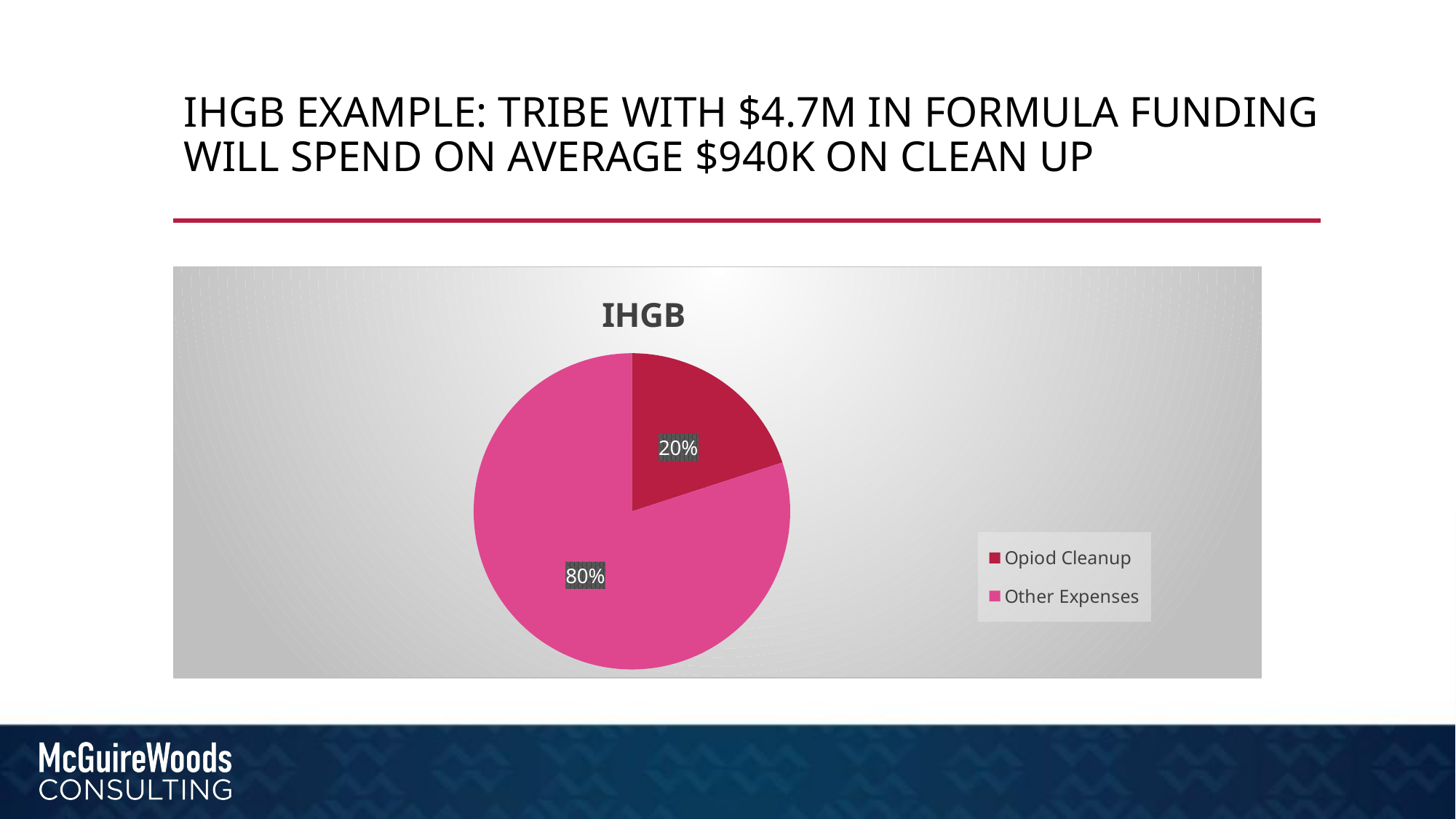
What type of chart is shown on the slide? Pie chart Which slice of the pie is the largest? Other Expenses What share of the pie does Opiod Cleanup represent? 20% Which is larger, the Opiod Cleanup slice or the Other Expenses slice? Other Expenses What is the difference in percentage points between the Other Expenses slice and the Opiod Cleanup slice? 60 How many entries does the legend list? 2 What is the title of the chart? IHGB What colour is the Opiod Cleanup slice? Dark red What share of the pie does Other Expenses represent? 80% Which slice of the pie is the smallest? Opiod Cleanup How many slices does the pie chart have? 2